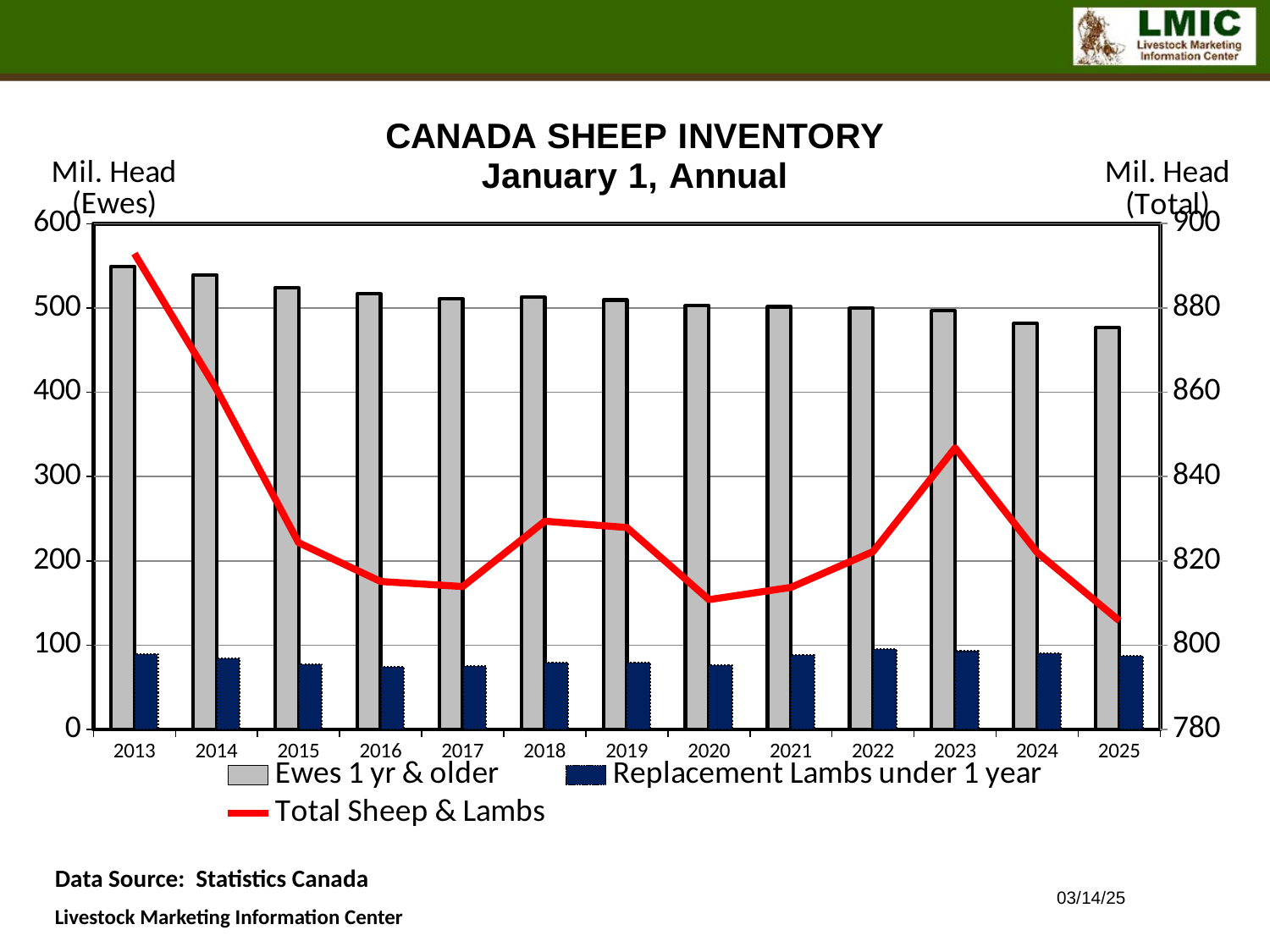
How many series does the chart legend list? 3 Which year has the larger Total Sheep & Lambs value, 2023 or 2020? 2023 Is the Ewes 1 yr & older value for 2025 greater or less than 500? less Which year has the highest value for Total Sheep & Lambs? 2013 What kind of chart is used to show the Ewes 1 yr & older and Replacement Lambs series? bar chart What is the title of the chart? CANADA SHEEP INVENTORY January 1, Annual Do the Ewes 1 yr & older values generally rise or fall from 2013 to 2025? fall Which year has the highest value for Ewes 1 yr & older? 2013 Is the Total Sheep & Lambs value for 2020 greater or less than 820? less How many years are shown on the x axis of the chart? 13 Is the Total Sheep & Lambs value for 2013 greater or less than 880? greater